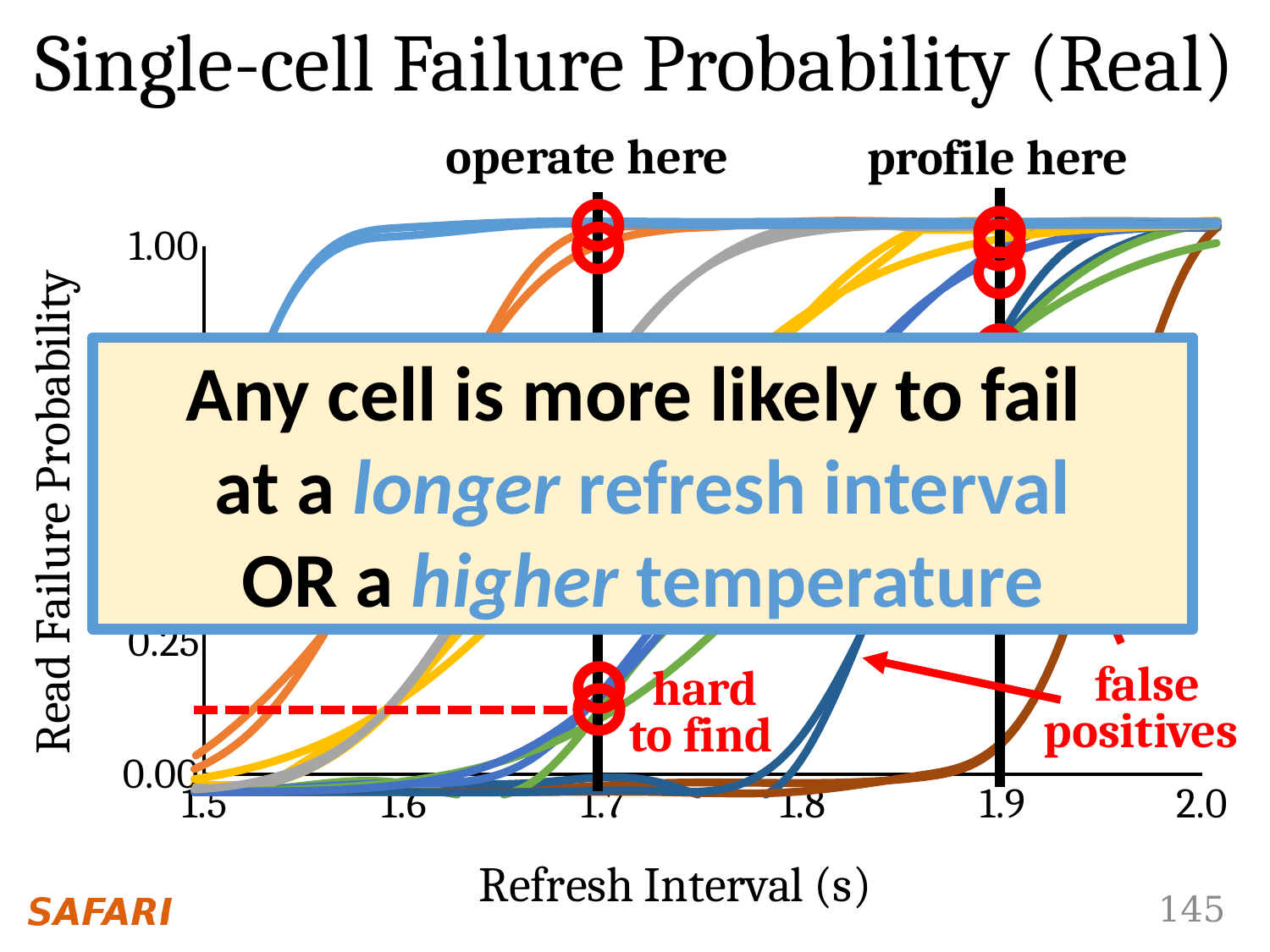
Is the value of the brown curve at a refresh interval of 1.7 greater or less than 0.25? less What is the label of the x axis of the chart? Refresh Interval (s) At which refresh interval is the vertical line labelled 'profile here' drawn? 1.9 What is the highest tick value shown on the x axis of the chart? 2.0 What is the highest tick value shown on the y axis of the chart? 1.00 Do the plotted curves rise or fall as the refresh interval increases? rise What is the lowest tick value shown on the x axis of the chart? 1.5 What is the title of the chart on the slide? Single-cell Failure Probability (Real) At which refresh interval is the vertical line labelled 'operate here' drawn? 1.7 Is the value of the light blue curve at a refresh interval of 1.7 greater or less than 0.25? greater What kind of chart is shown on the slide? line chart